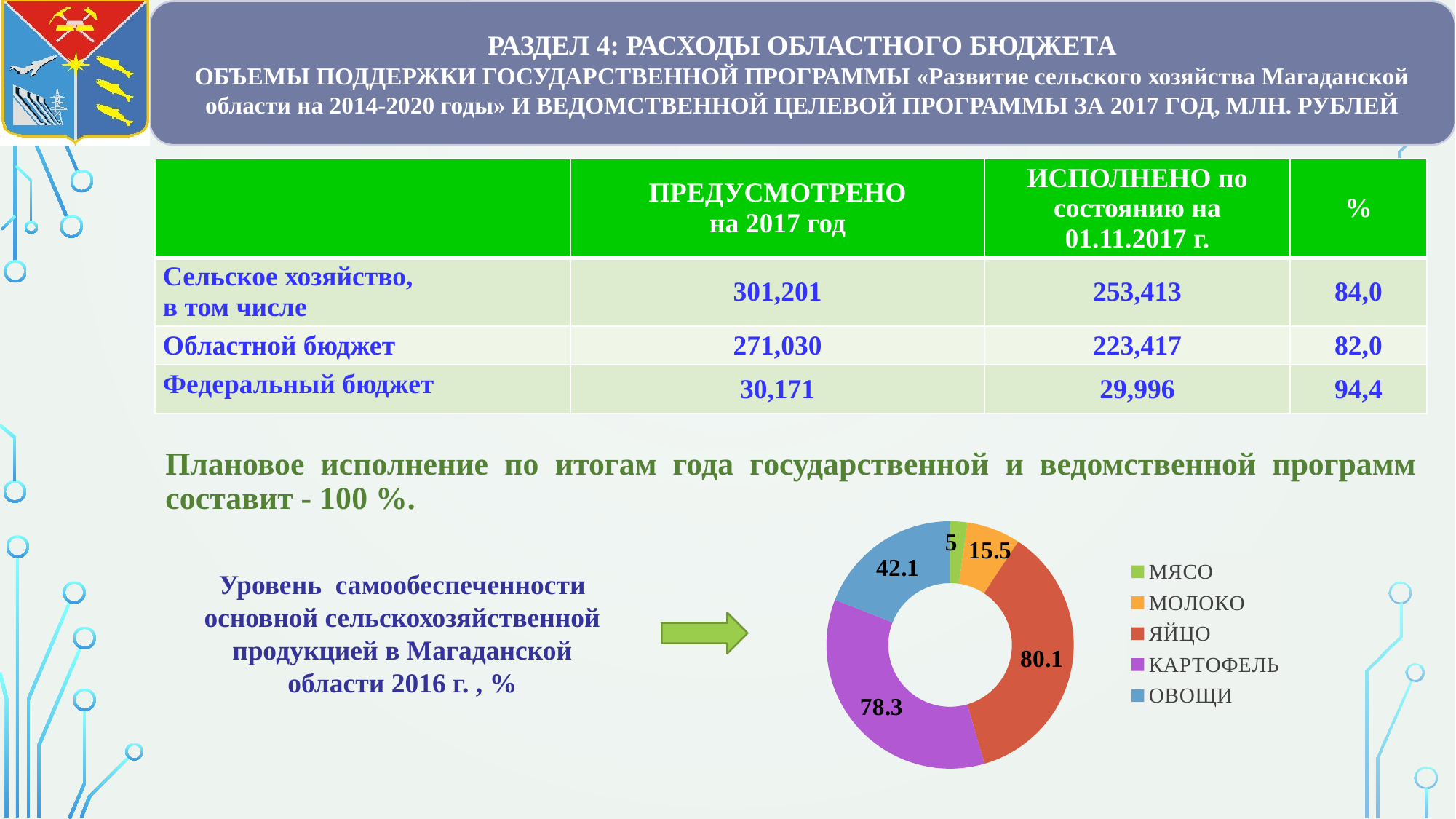
Which category has the lowest value in the doughnut chart? МЯСО In the doughnut chart, what is the value for КАРТОФЕЛЬ? 78.3 Which category has the highest value in the doughnut chart? ЯЙЦО How many categories does the legend of the doughnut chart list? 5 What kind of chart is shown on the slide? Doughnut (pie) chart What is the difference between the values for ОВОЩИ and МОЛОКО in the doughnut chart? 26.6 In the doughnut chart, what is the value for МОЛОКО? 15.5 What is the difference between the values for ЯЙЦО and КАРТОФЕЛЬ in the doughnut chart? 1.8 In the doughnut chart, what is the value for ЯЙЦО? 80.1 In the doughnut chart, what is the value for ОВОЩИ? 42.1 In the doughnut chart, what is the value for МЯСО? 5 Which colour represents КАРТОФЕЛЬ in the doughnut chart? Purple